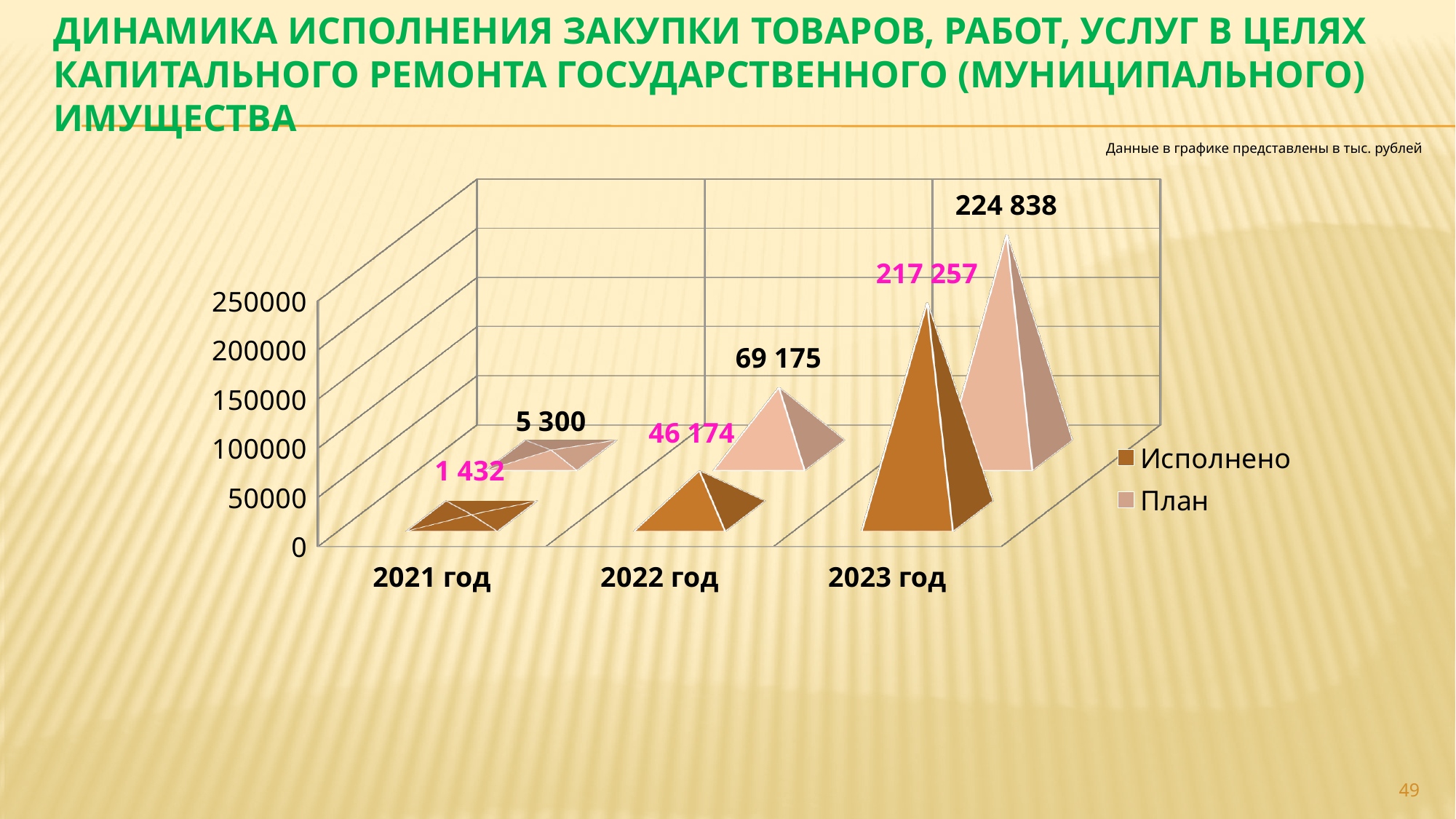
Which year has the lowest Исполнено value? 2021 год What is the value of План for 2023 год? 224 838 How many years are shown on the x axis? 3 How many series does the legend list? 2 Which is larger for 2021 год: План or Исполнено? План Which year has the highest План value? 2023 год What is the value of План for 2022 год? 69 175 What is the difference between План and Исполнено for 2023 год? 7 581 What is the difference between План and Исполнено for 2022 год? 23 001 Do the Исполнено values rise or fall from 2021 год to 2023 год? rise What is the value of Исполнено for 2023 год? 217 257 What is the value of Исполнено for 2021 год? 1 432